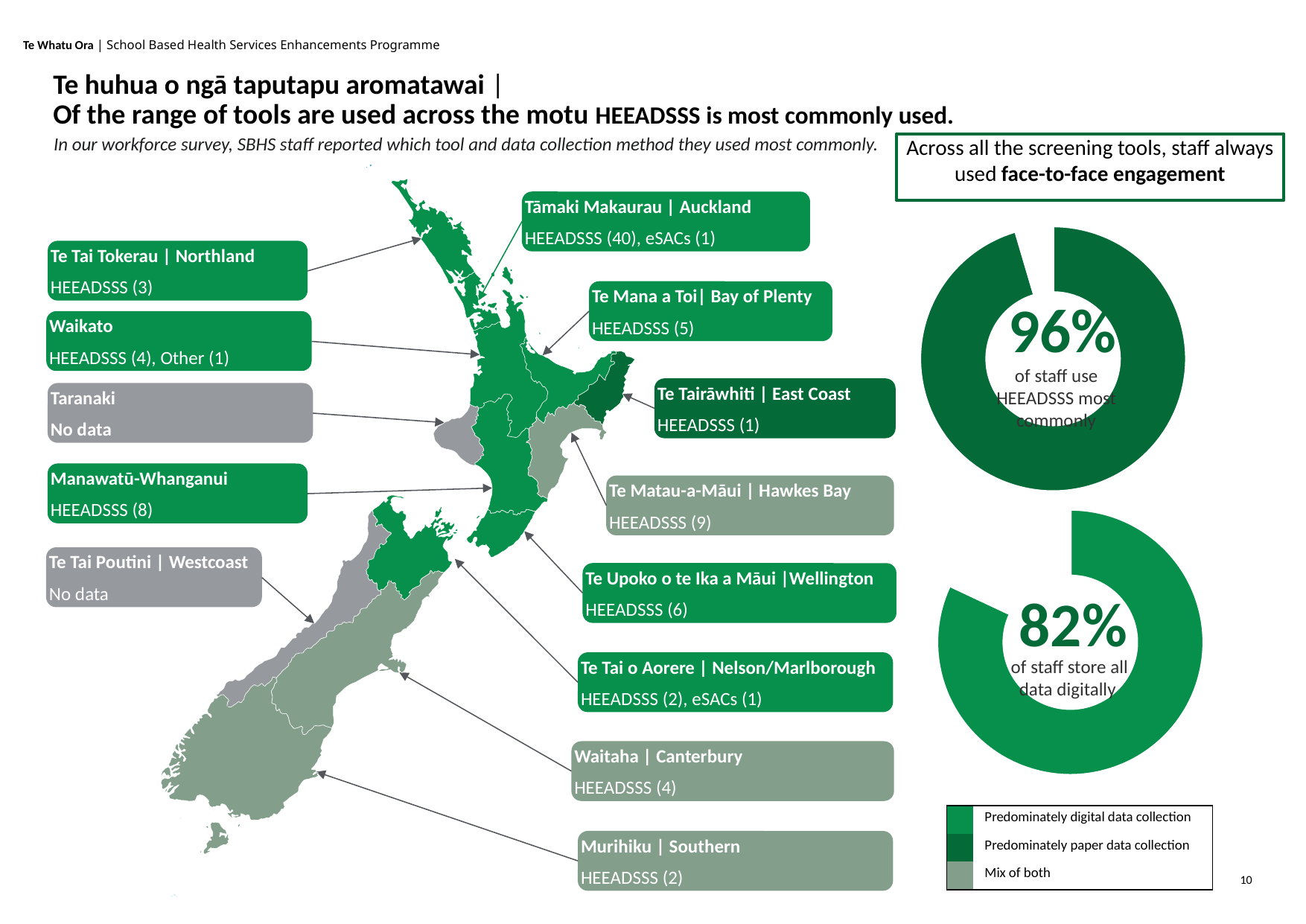
On the map, which region reports the highest number of HEEADSSS responses? Tāmaki Makaurau | Auckland According to the upper donut chart, what percentage of staff use HEEADSSS most commonly? 96% According to the lower donut chart, what percentage of staff store all data digitally? 82% How many donut charts are shown on the right side of the slide? 2 On the map, how many HEEADSSS responses are reported for Te Matau-a-Māui | Hawkes Bay? 9 How many categories does the legend at the bottom right of the slide list? 3 What kind of chart is used to show the 96% figure on the right of the slide? Donut (pie) chart On the map, how many HEEADSSS responses are reported for Tāmaki Makaurau | Auckland? 40 Is the share of staff who store all data digitally greater or less than 50%? greater Which two regions on the map are labelled as having no data? Taranaki and Te Tai Poutini | Westcoast Which is larger: the share of staff who use HEEADSSS most commonly or the share of staff who store all data digitally? The share who use HEEADSSS most commonly (96%) What is the difference in percentage points between the 96% donut chart and the 82% donut chart? 14 percentage points